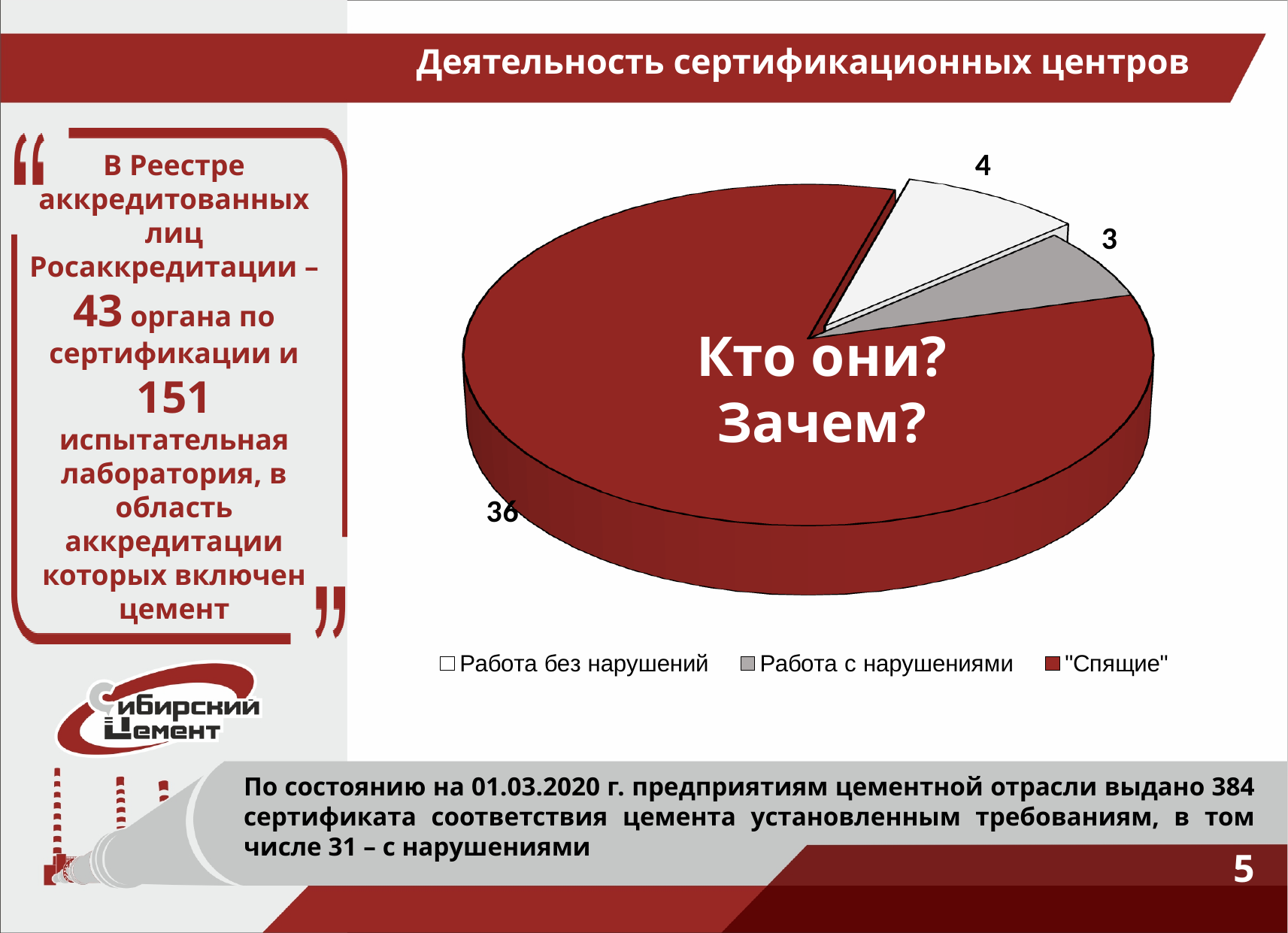
Which category has the smallest slice in the pie chart? Работа с нарушениями What is the difference between the values for "Работа без нарушений" and "Работа с нарушениями"? 1 Which is larger: the value for "Работа без нарушений" or the value for "Работа с нарушениями"? Работа без нарушений What is the value for "Спящие" in the pie chart? 36 What is the value for "Работа без нарушений" in the pie chart? 4 Which category has the largest slice in the pie chart? "Спящие" How many entries does the legend of the pie chart list? 3 What kind of chart is shown on the slide? pie chart What is the difference between the values for "Спящие" and "Работа без нарушений"? 32 What colour is the "Спящие" slice in the pie chart? red What is the value for "Работа с нарушениями" in the pie chart? 3 How many slices does the pie chart have? 3